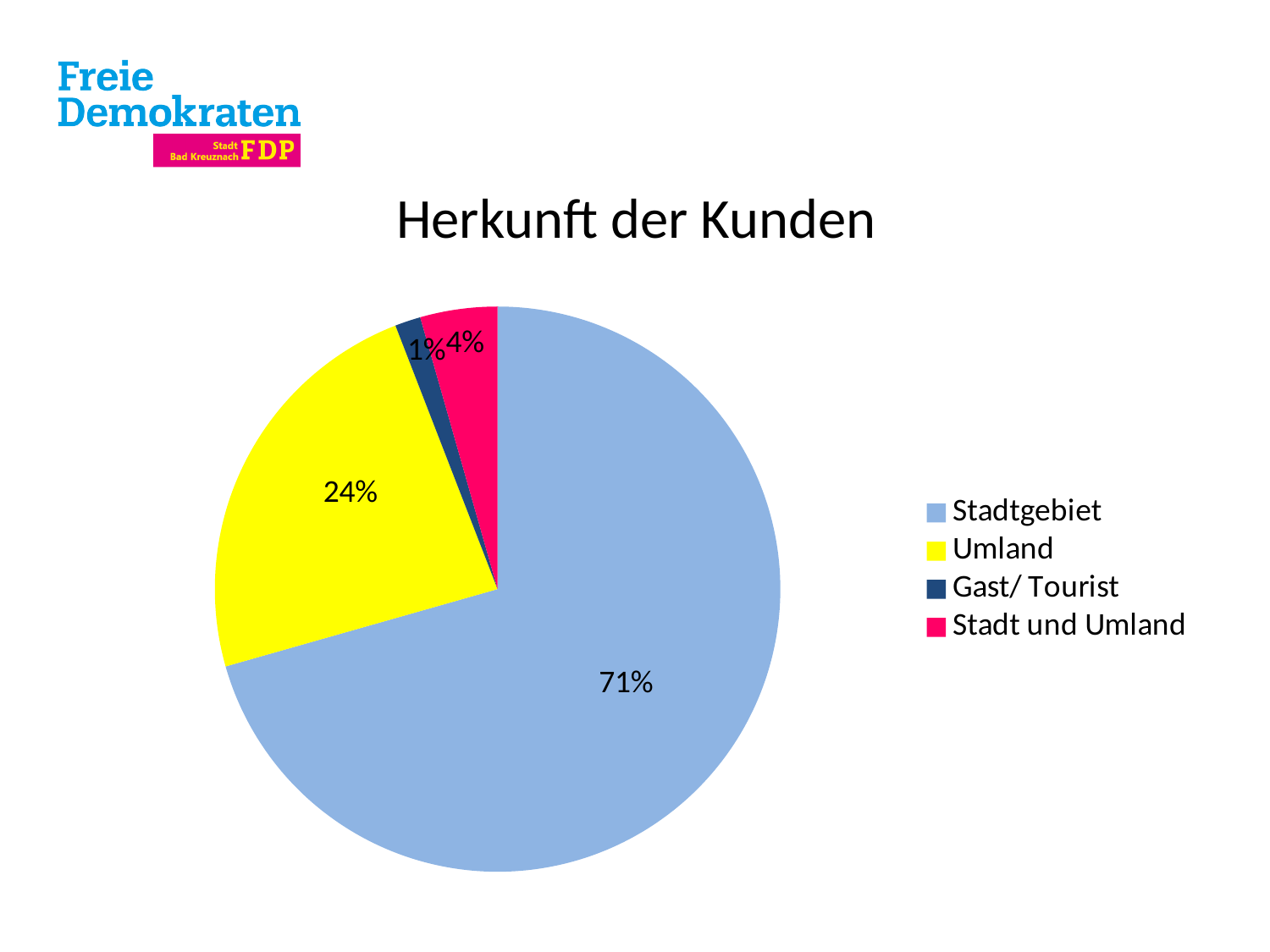
What share of the pie does Stadtgebiet have? 71% What share of the pie does Gast/ Tourist have? 1% What is the difference in percentage points between Stadtgebiet and Umland? 47 What share of the pie does Stadt und Umland have? 4% Which category has the largest share of the pie? Stadtgebiet How many categories does the pie chart show? 4 Which colour represents Umland in the pie chart? Yellow What kind of chart is shown on the slide? Pie chart Which category has the smallest share of the pie? Gast/ Tourist Which is larger, the share for Umland or the share for Stadt und Umland? Umland What is the title of the chart? Herkunft der Kunden